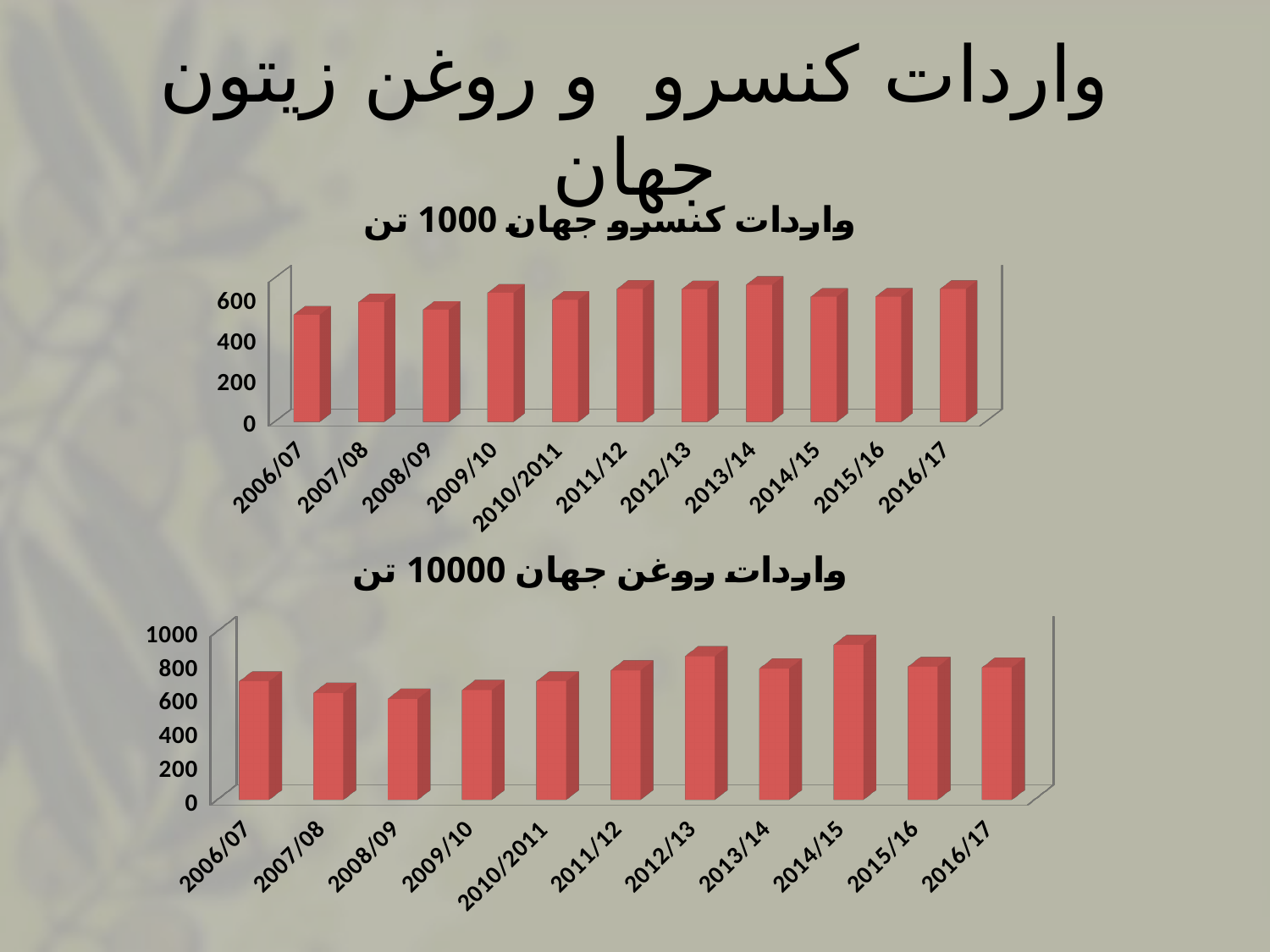
How many bars are there in the bottom chart "واردات روغن جهان 10000 تن"? 11 In the bottom chart "واردات روغن جهان 10000 تن", is the value for 2014/15 greater or less than 800? greater How many categories (years) are shown on the x axis of the top chart "واردات کنسرو جهان 1000 تن"? 11 In the top chart "واردات کنسرو جهان 1000 تن", is the value for 2006/07 greater or less than 400? greater What is the highest tick value shown on the vertical axis of the bottom chart "واردات روغن جهان 10000 تن"? 1000 In the bottom chart "واردات روغن جهان 10000 تن", which is larger, the value for 2012/13 or the value for 2008/09? 2012/13 What kind of chart is the bottom chart titled "واردات روغن جهان 10000 تن"? bar chart In the bottom chart "واردات روغن جهان 10000 تن", is the value for 2008/09 greater or less than 800? less What kind of chart is the top chart titled "واردات کنسرو جهان 1000 تن"? bar chart What is the first category label on the x axis of the top chart "واردات کنسرو جهان 1000 تن"? 2006/07 In the bottom chart "واردات روغن جهان 10000 تن", which year has the highest value? 2014/15 In the top chart "واردات کنسرو جهان 1000 تن", which is larger, the value for 2013/14 or the value for 2006/07? 2013/14